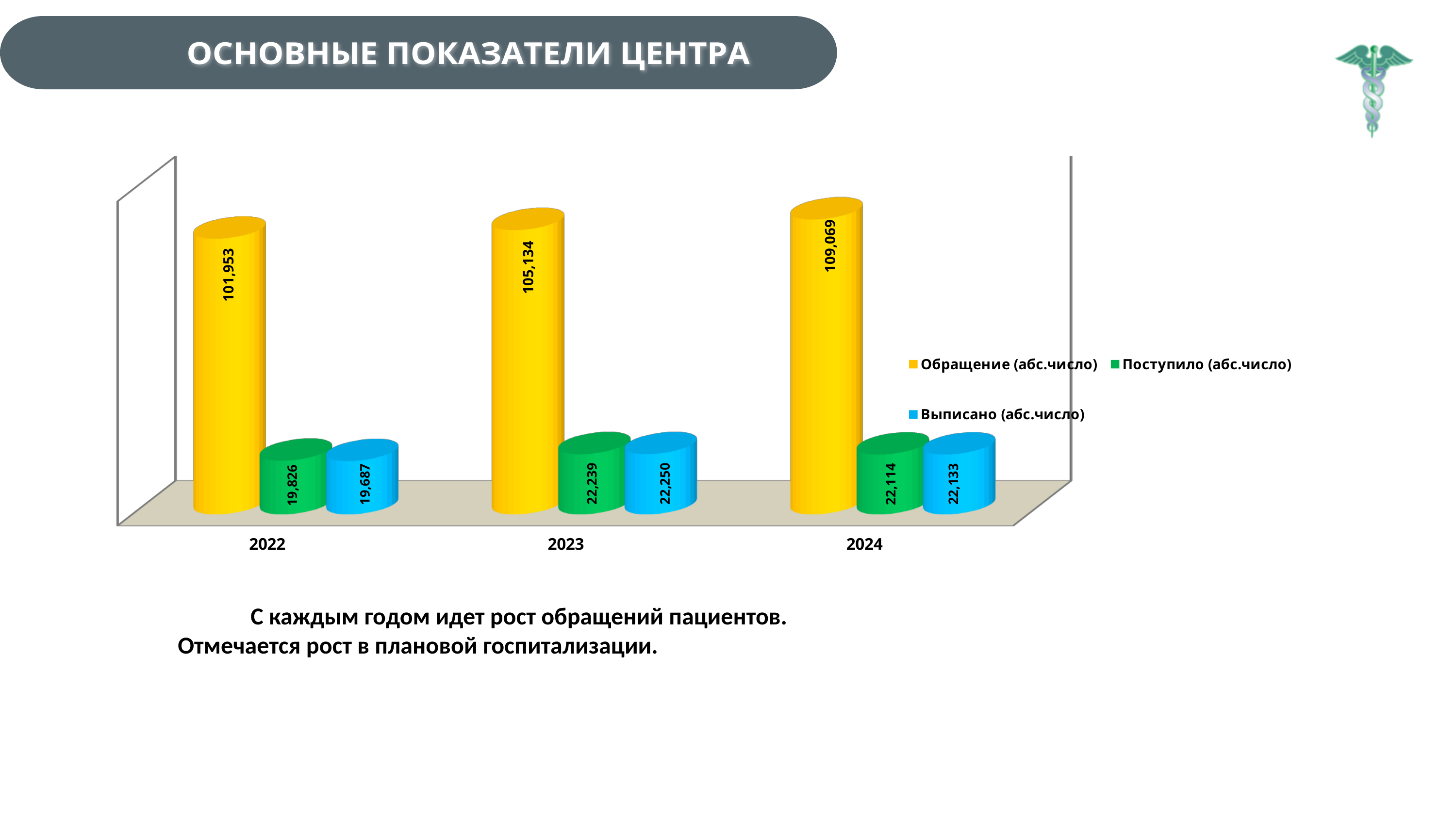
What is the value of Выписано (абс.число) for 2024? 22,133 How many series does the legend list? 3 What is the value of Поступило (абс.число) for 2023? 22,239 What kind of chart is shown on the slide? Bar chart What is the difference between Обращение (абс.число) in 2024 and in 2023? 3,935 What is the value of Обращение (абс.число) for 2022? 101,953 Which is larger: Обращение (абс.число) in 2022 or in 2023? 2023 What is the value of Обращение (абс.число) for 2024? 109,069 What is the difference between Поступило (абс.число) and Выписано (абс.число) in 2022? 139 In which year is Поступило (абс.число) lowest? 2022 How many years are shown on the x axis? 3 In which year is Обращение (абс.число) highest? 2024